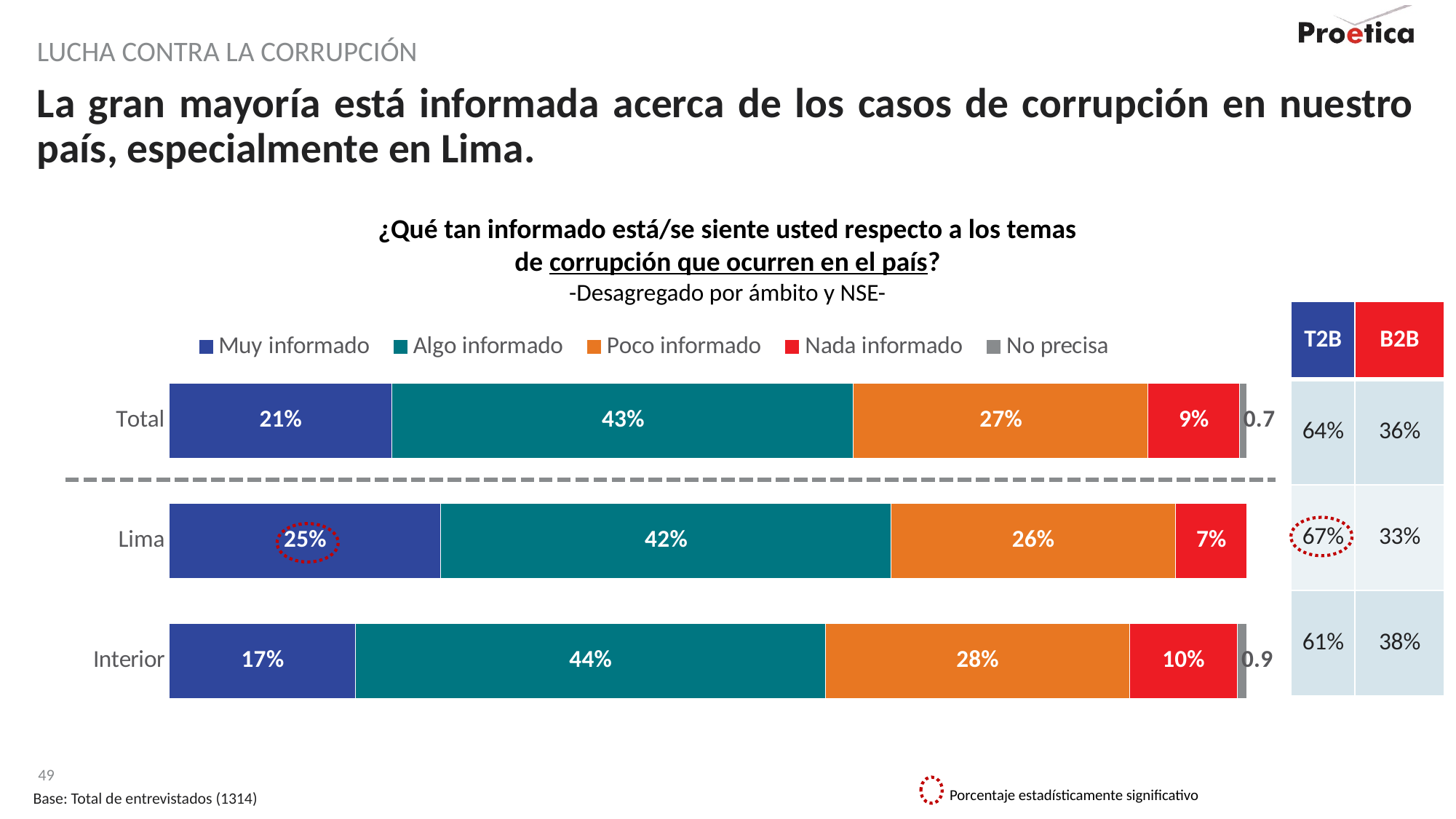
What is the "Nada informado" value for Total? 9% Which category has the highest "Muy informado" value? Lima Which category has the lowest "Nada informado" value? Lima What is the "Algo informado" value for Interior? 44% What kind of chart is shown on the slide? Stacked bar chart What percentage of respondents in Lima are "Muy informado"? 25% How many series does the legend list? 5 What is the "No precisa" value shown for Interior? 0.9 What is the T2B value for Lima in the table to the right of the chart? 67% How many categories (bars) are shown in the chart? 3 What is the difference between the "Muy informado" values for Lima and Interior? 8% Which is larger: the "Poco informado" value for Total or for Interior? Interior